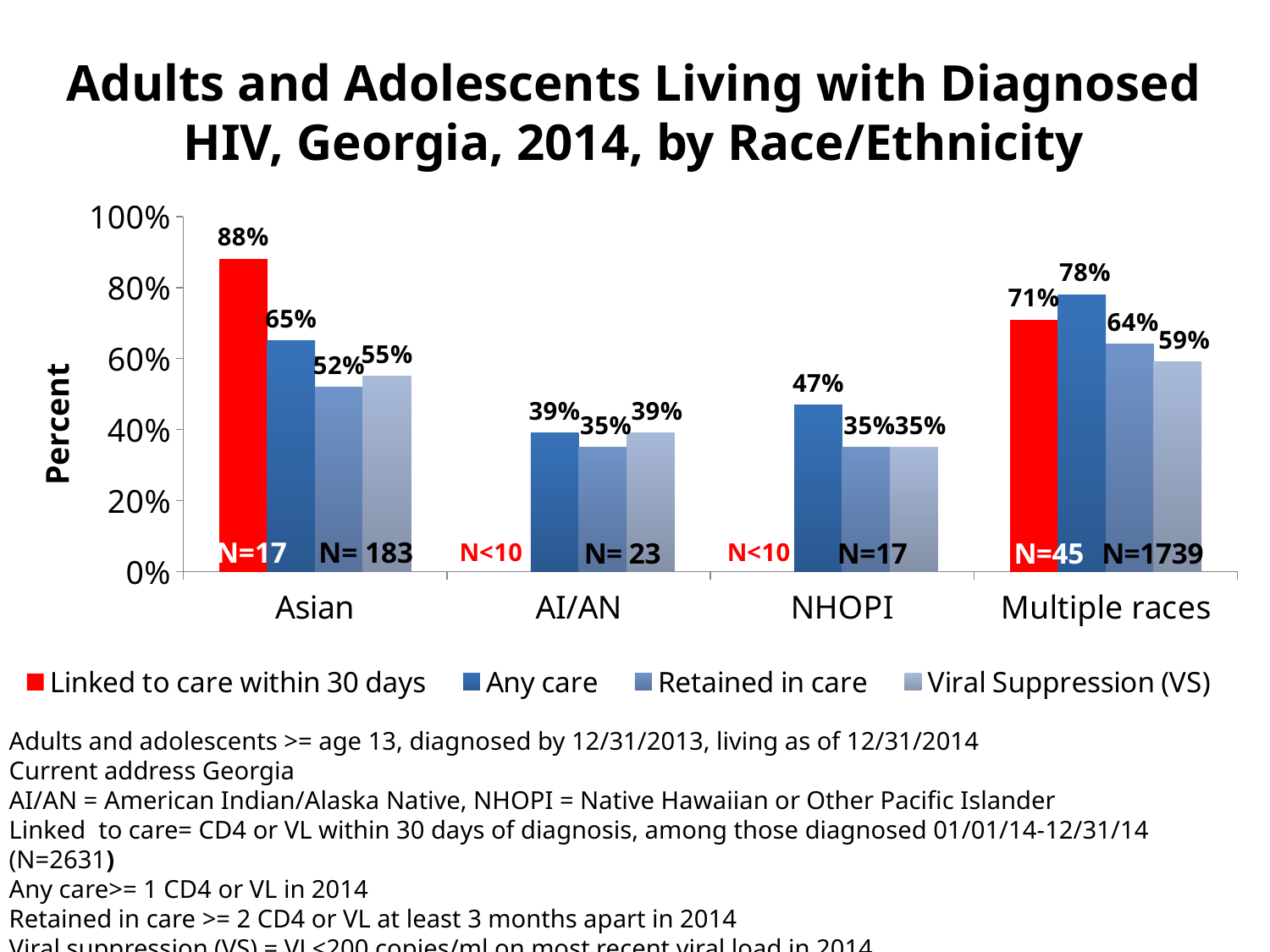
Which is larger, the Any care value for Asian or the Any care value for AI/AN? Asian What is the difference between the Linked to care within 30 days values for Asian and Multiple races? 17% How many series does the legend list? 4 What is the Viral Suppression (VS) value for the Multiple races group? 59% What is the Any care value for NHOPI? 47% What kind of chart is shown on the slide? Bar chart Which race/ethnicity group has the highest Any care percentage? Multiple races Which series is shown in red in the legend? Linked to care within 30 days What percentage of Asian adults and adolescents were linked to care within 30 days? 88% How many race/ethnicity categories are shown on the x axis? 4 What is the label on the y axis? Percent Which race/ethnicity group has the lowest Retained in care percentage? AI/AN and NHOPI (tied at 35%)